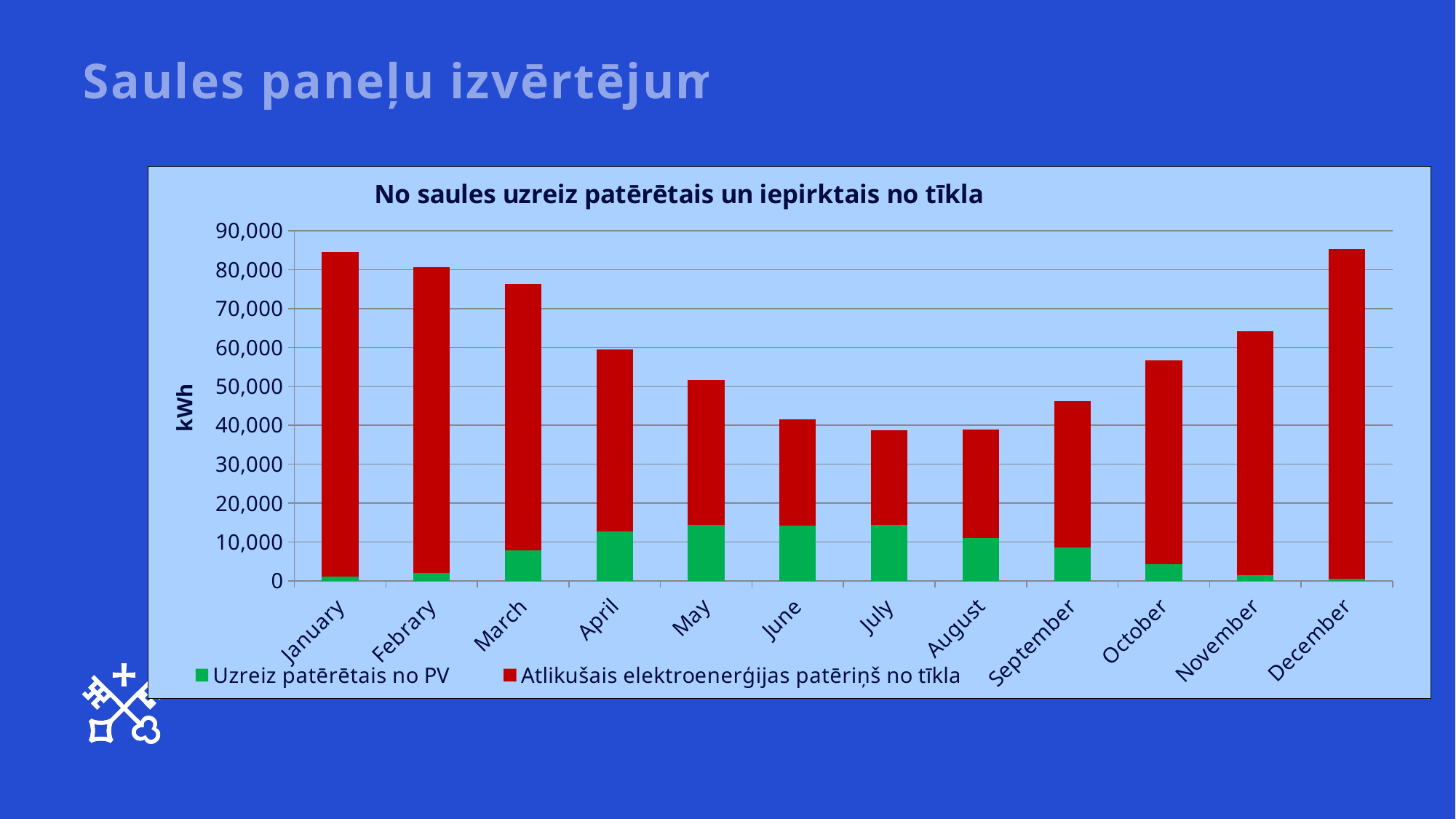
What is the title of the chart? No saules uzreiz patērētais un iepirktais no tīkla Is the total bar height for January greater or less than 80,000? greater Is the total bar height for November greater or less than 60,000? greater How many months are shown on the x axis of the chart? 12 Which month has the larger 'Uzreiz patērētais no PV' value, April or October? April Is the total bar height for July greater or less than 40,000? less What is the label on the vertical axis of the chart? kWh Which month has the taller total bar, January or July? January What kind of chart is shown on the slide? bar chart Do the total bar heights rise or fall from January to July? fall How many series does the chart's legend list? 2